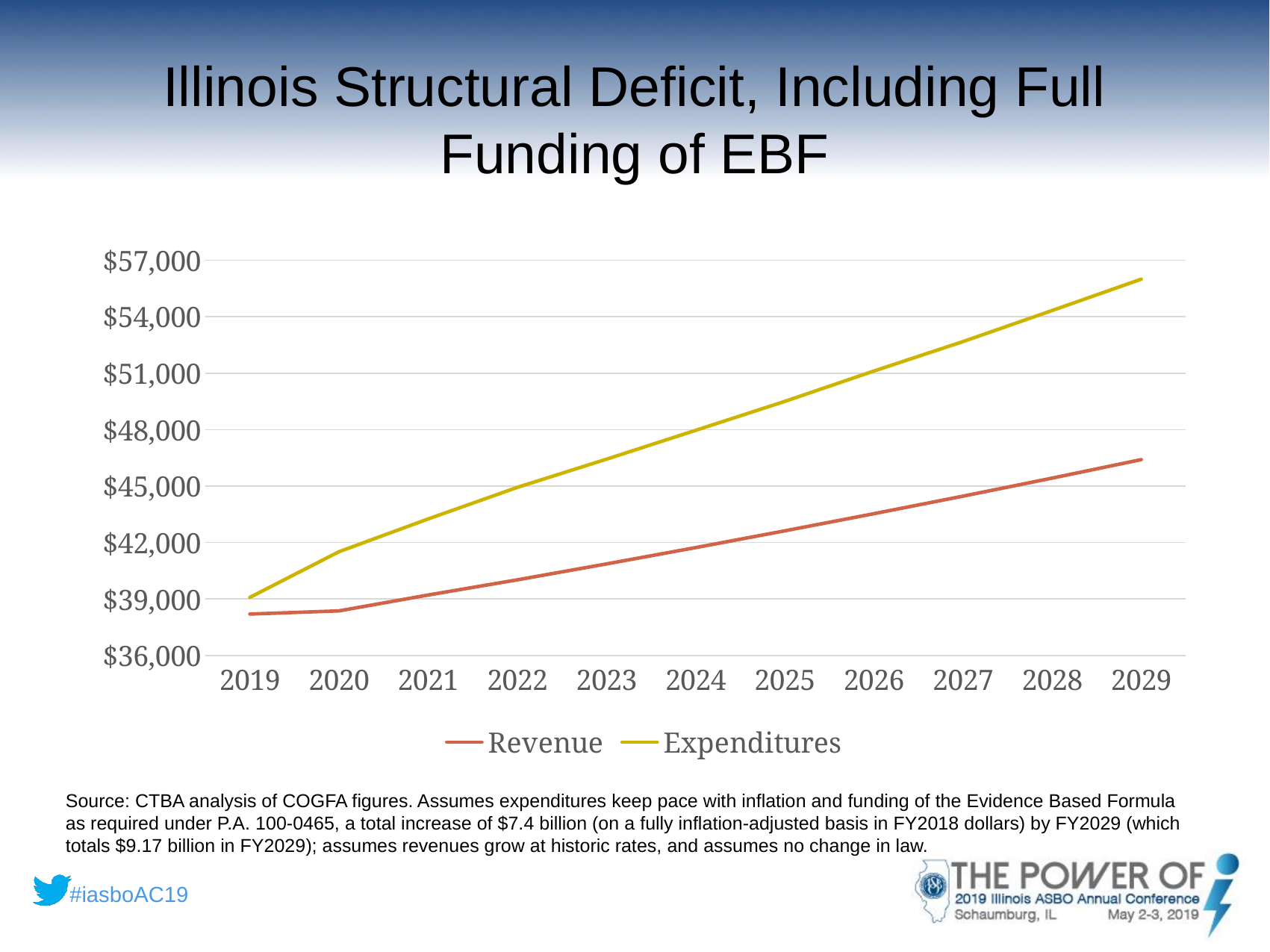
Which series has the higher value in 2029, Revenue or Expenditures? Expenditures How many years are shown along the x axis? 11 Is the Expenditures value for 2029 greater or less than $54,000? greater Is the Revenue value for 2029 greater or less than $48,000? less What kind of chart is shown on the slide? line chart How many series does the legend list? 2 What colour is the Expenditures line? yellow What are the two series named in the legend? Revenue and Expenditures Is the Expenditures value for 2024 greater or less than $45,000? greater In which year is the Revenue line at its lowest? 2019 Does the Expenditures line rise or fall from 2019 to 2029? rise